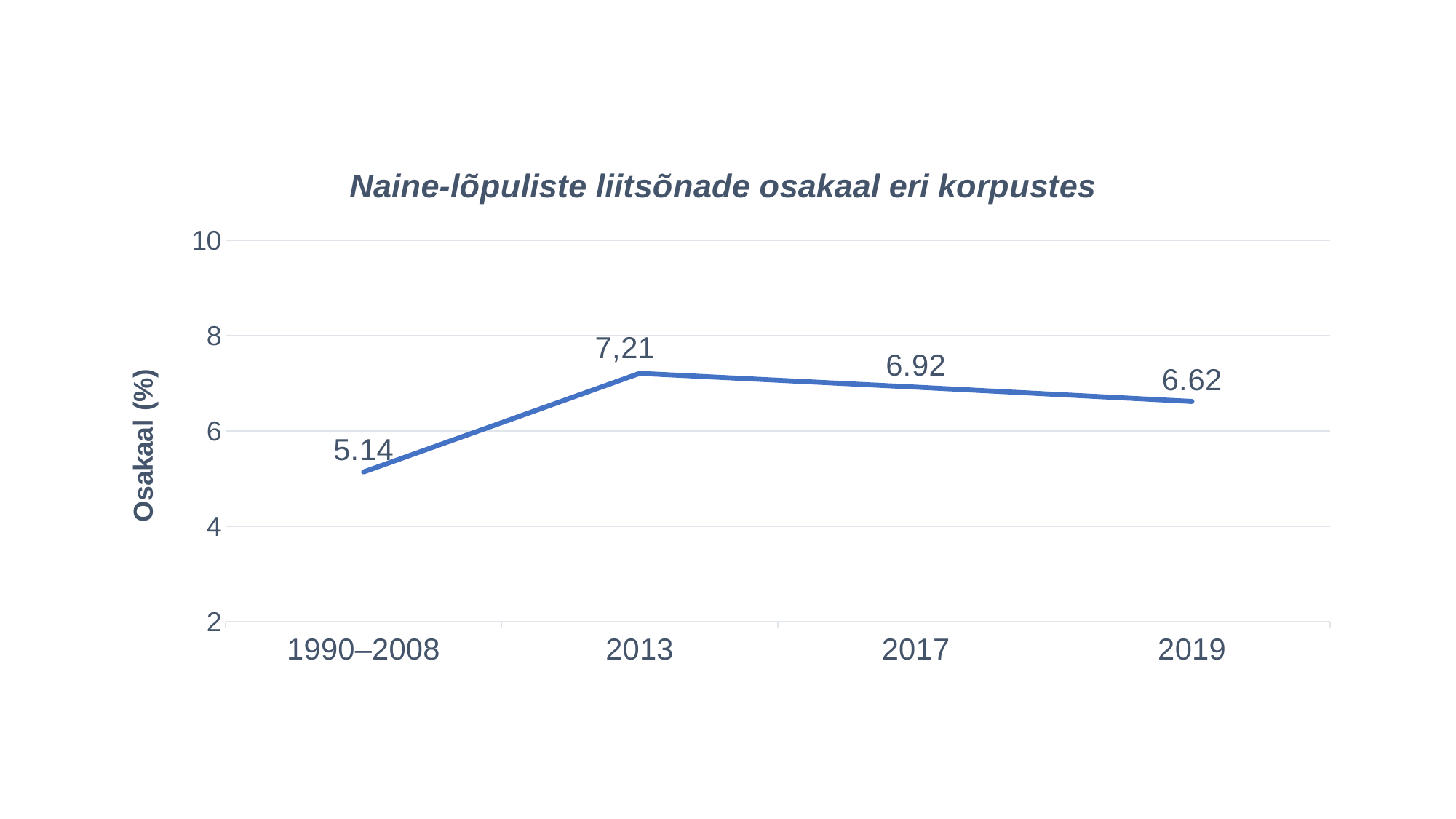
What is the difference between the values for 2017 and 2019? 0.30 What is the value for 1990–2008? 5.14 What is the value for 2019? 6.62 What is the value for 2013? 7,21 Which is larger, the value for 2017 or the value for 2019? 2017 Which category has the lowest value? 1990–2008 What is the title of the chart? Naine-lõpuliste liitsõnade osakaal eri korpustes Which category has the highest value? 2013 How many categories are shown on the x axis? 4 Is the value for 1990–2008 greater or less than 6? less What kind of chart is shown on the slide? line chart What is the value for 2017? 6.92